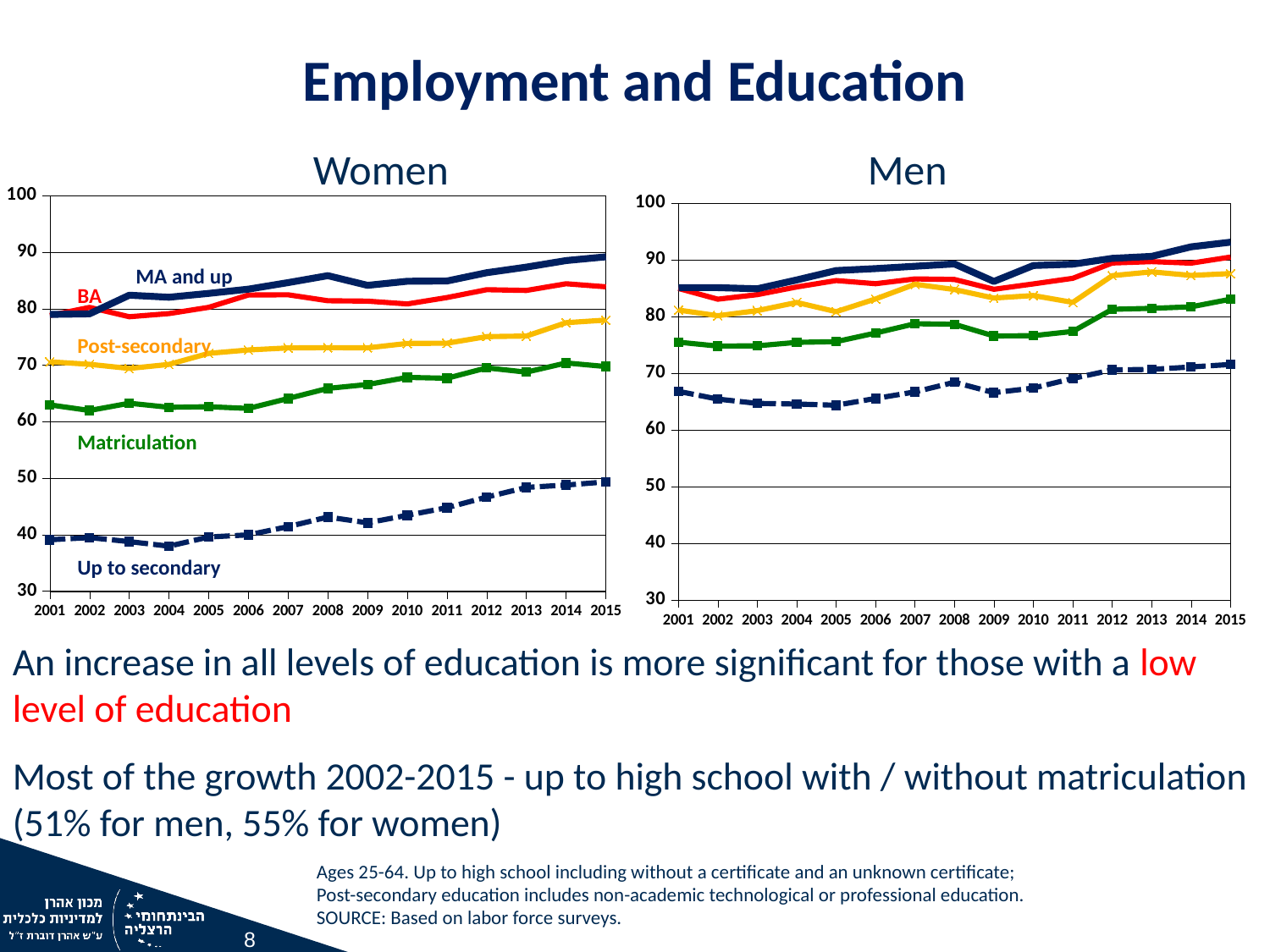
In the Women chart, is the value for Up to secondary in 2008 greater or less than 40? greater In the Women chart, which education level has the highest value in 2015? MA and up What is the title of the chart on the left? Women What kind of chart is the Women chart? line chart In the Women chart, how many education-level series are labelled? 5 In the Women chart, how many years are shown on the x axis? 15 In the Women chart, is the value for Matriculation in 2001 greater or less than 70? less In the Women chart, does the Up to secondary line rise or fall from 2001 to 2015? rise In the Women chart, which is larger in 2015: BA or Post-secondary? BA In the Women chart, is the value for MA and up in 2015 greater or less than 80? greater In the Women chart, which education level has the lowest values across all years? Up to secondary